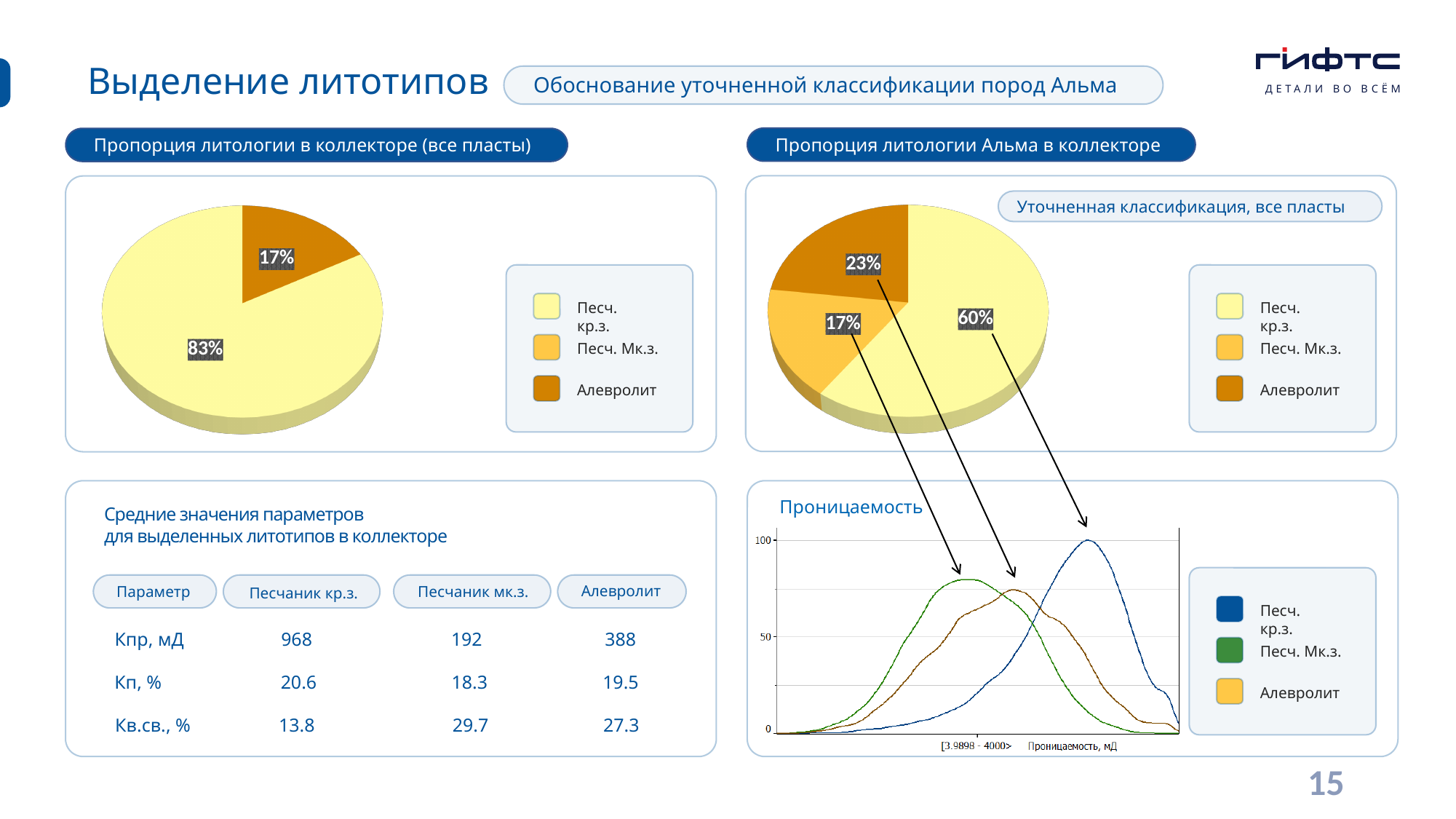
On the right pie chart 'Пропорция литологии Альма в коллекторе', what share is labelled for Песч. Мк.з.? 17% How many series does the legend of the 'Проницаемость' chart list? 3 On the right pie chart 'Пропорция литологии Альма в коллекторе', what share is labelled for Песч. кр.з.? 60% On the right pie chart 'Пропорция литологии Альма в коллекторе', which is larger: the Алевролит slice or the Песч. Мк.з. slice? Алевролит On the left pie chart 'Пропорция литологии в коллекторе (все пласты)', which category has the largest slice? Песч. кр.з. On the right pie chart 'Пропорция литологии Альма в коллекторе', which category has the smallest slice? Песч. Мк.з. On the right pie chart 'Пропорция литологии Альма в коллекторе', how many slices are labelled with percentages? 3 On the left pie chart 'Пропорция литологии в коллекторе (все пласты)', what share is labelled for Алевролит? 17% What kind of chart is the 'Проницаемость' chart at the bottom right of the slide? Line chart On the left pie chart 'Пропорция литологии в коллекторе (все пласты)', what is the difference between the Песч. кр.з. share and the Алевролит share? 66%